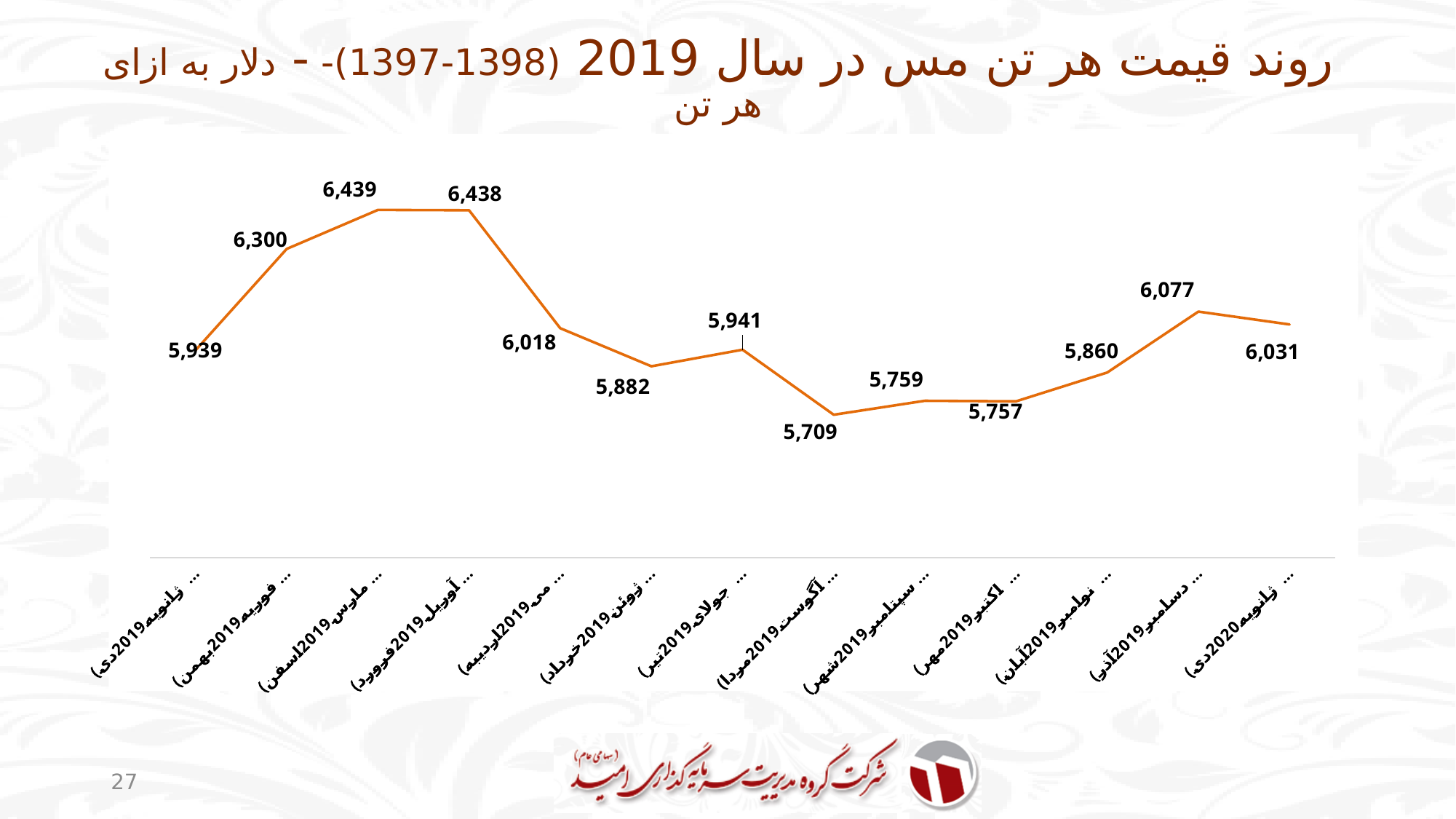
What is the value shown for August 2019 (آگوست 2019)? 5,709 What is the value shown for December 2019 (دسامبر 2019)? 6,077 What is the difference between the values for December 2019 and November 2019? 217 What is the value shown for January 2020 (ژانویه 2020)? 6,031 What is the copper price per ton for January 2019 (ژانویه 2019)? 5,939 What is the value shown for March 2019 (مارس 2019)? 6,439 Do the values rise or fall from April 2019 to August 2019? Fall What is the difference between the values for March 2019 and January 2019? 500 What kind of chart is shown on the slide? Line chart Which is larger, the value for February 2019 or the value for May 2019? February 2019 Which month has the lowest copper price on the chart? August 2019 (آگوست 2019) How many data points are plotted on the chart? 13